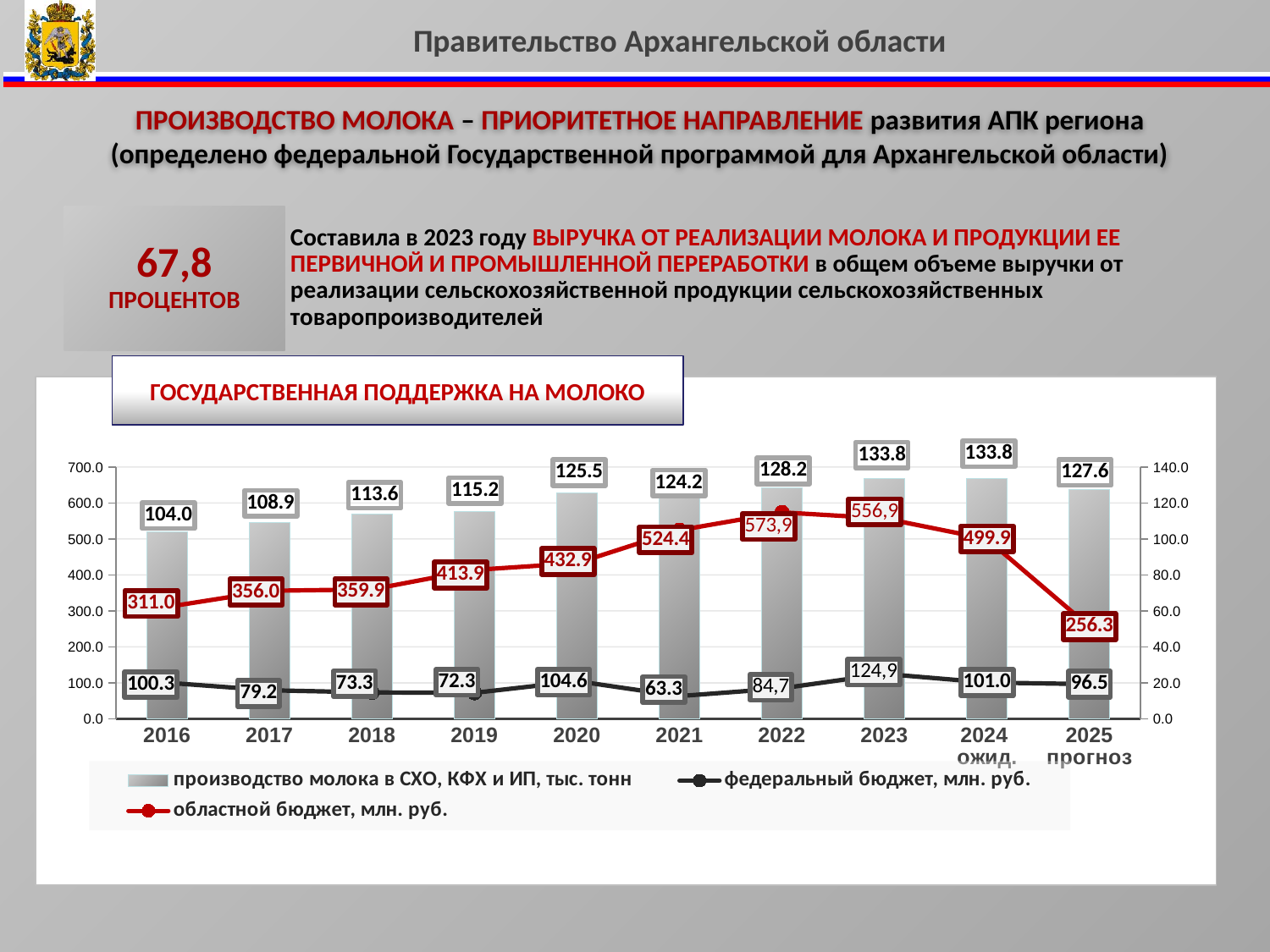
What is the milk production value (производство молока) for 2019? 115.2 In which year is the regional budget (областной бюджет) value the lowest? 2025 What is the difference between the regional budget values for 2024 and 2025? 243.6 Does the regional budget (областной бюджет) series rise or fall from 2016 to 2022? Rise What is the value of the regional budget (областной бюджет) series for 2022? 573,9 How many series does the chart legend list? 3 Which is larger: the federal budget value for 2016 or for 2020? 2020 What is the federal budget (федеральный бюджет) value for 2023? 124,9 What kind of chart is shown under the heading 'ГОСУДАРСТВЕННАЯ ПОДДЕРЖКА НА МОЛОКО'? Combined bar and line chart In which year is the regional budget (областной бюджет) value the highest? 2022 How many years are shown on the x axis of the chart? 10 In which year is the federal budget (федеральный бюджет) value the lowest? 2021